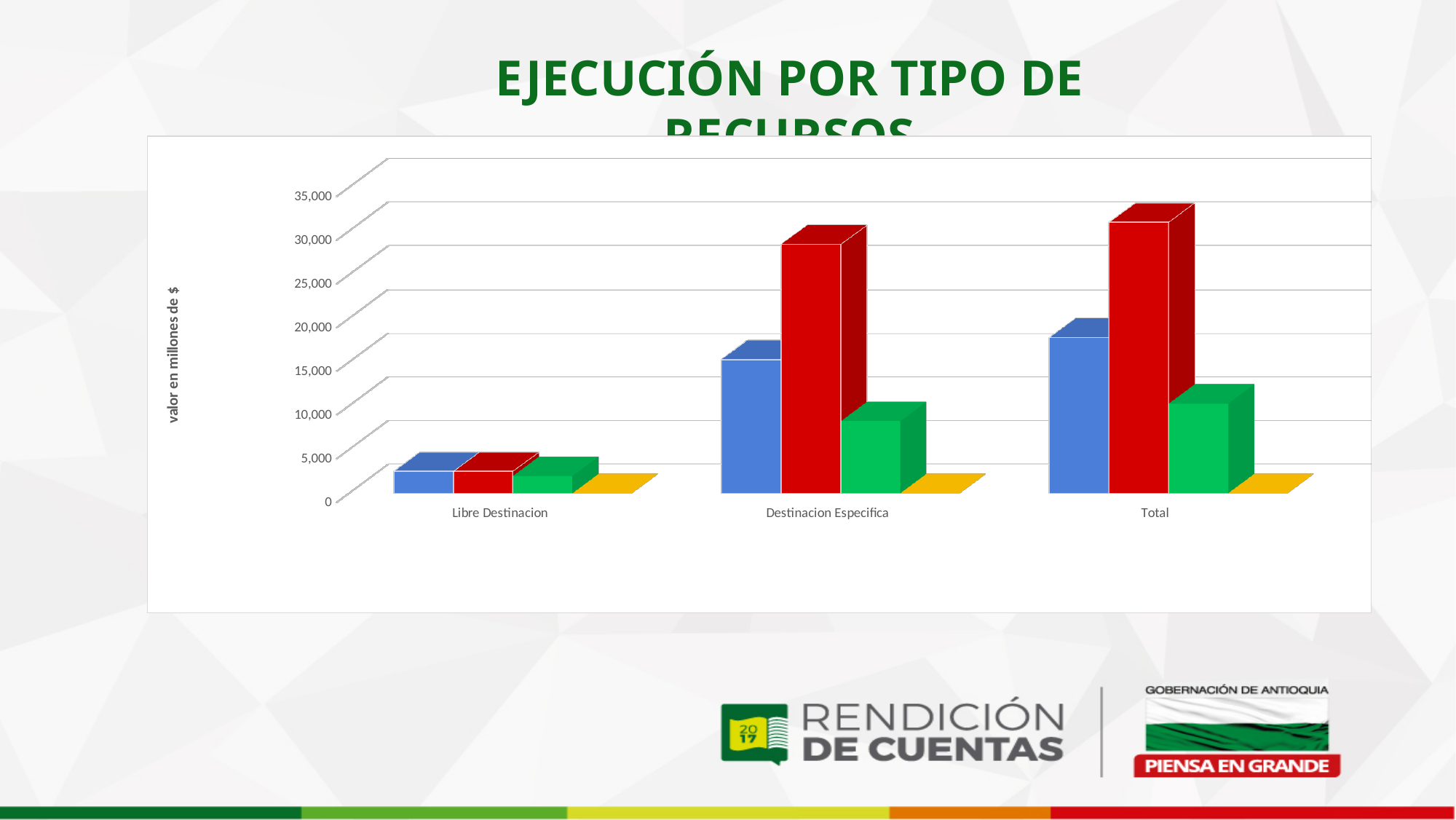
Is the red bar for Libre Destinacion greater or less than 5,000? less Is the red bar for Destinacion Especifica greater or less than 25,000? greater Is the blue bar for Destinacion Especifica greater or less than 20,000? less Which is larger, the blue bar for Destinacion Especifica or the blue bar for Total? Total How many categories are shown on the x axis of the chart? 3 Which category has the tallest red bar? Total Do the red bars rise or fall from Libre Destinacion to Total along the x axis? rise In the Total category, which is larger, the red bar or the blue bar? the red bar What kind of chart is shown on the slide? bar chart Which category has the shortest red bar? Libre Destinacion What is the title of the vertical axis of the chart? valor en millones de $